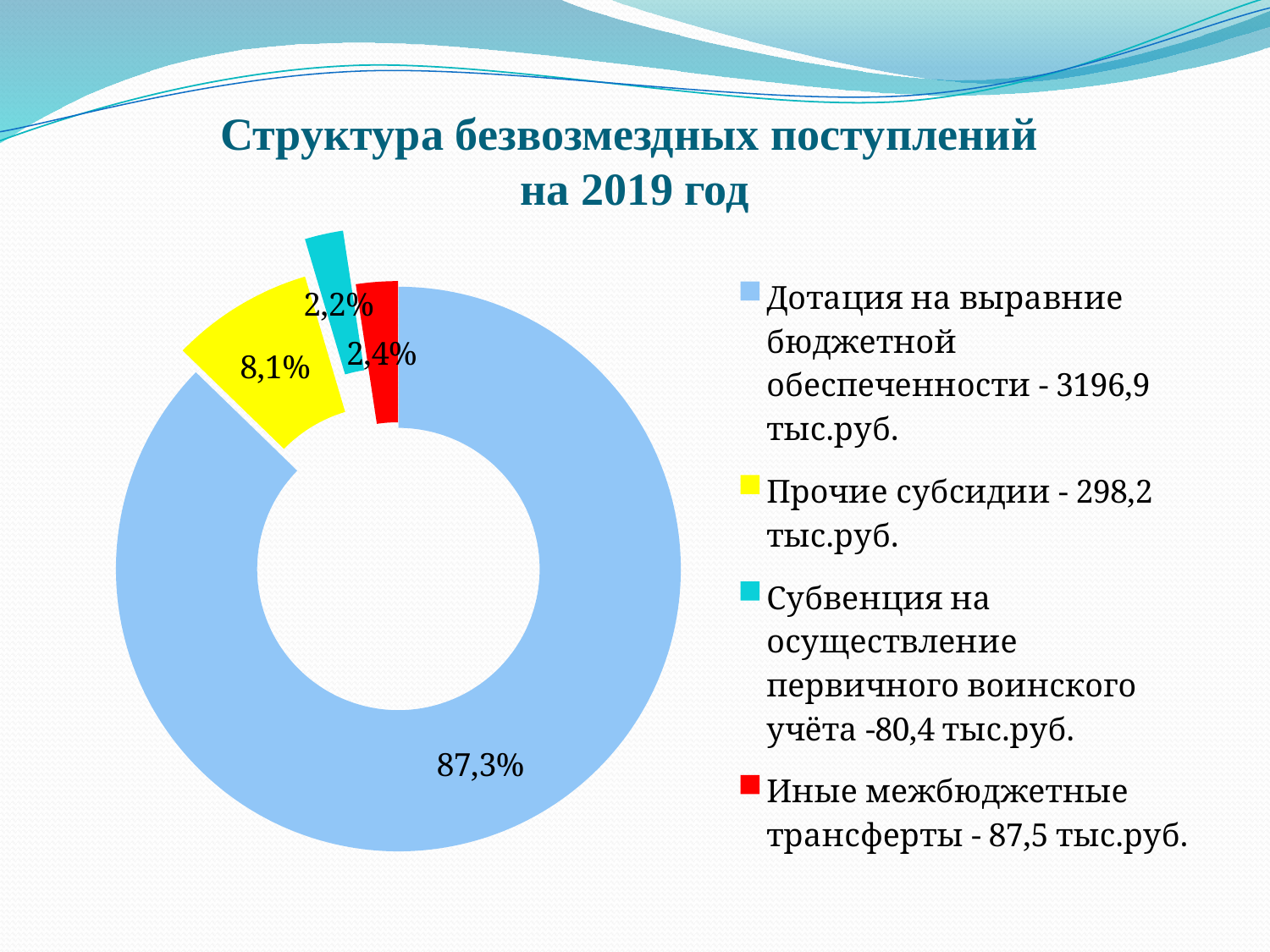
What share of the pie does "Дотация на выравние бюджетной обеспеченности" hold? 87,3% Which category has the largest slice of the pie? Дотация на выравние бюджетной обеспеченности What is the difference in percentage points between the shares of "Прочие субсидии" and "Иные межбюджетные трансферты"? 5,7 What share of the pie does "Прочие субсидии" hold? 8,1% What share of the pie does "Субвенция на осуществление первичного воинского учёта" hold? 2,2% What kind of chart is shown on the slide? Pie chart (doughnut) What colour is the slice for "Прочие субсидии"? Yellow Which category has the smallest slice of the pie? Субвенция на осуществление первичного воинского учёта What is the title of the slide's chart? Структура безвозмездных поступлений на 2019 год How many slices does the pie chart have? 4 Which is larger: the share of "Иные межбюджетные трансферты" or the share of "Субвенция на осуществление первичного воинского учёта"? Иные межбюджетные трансферты